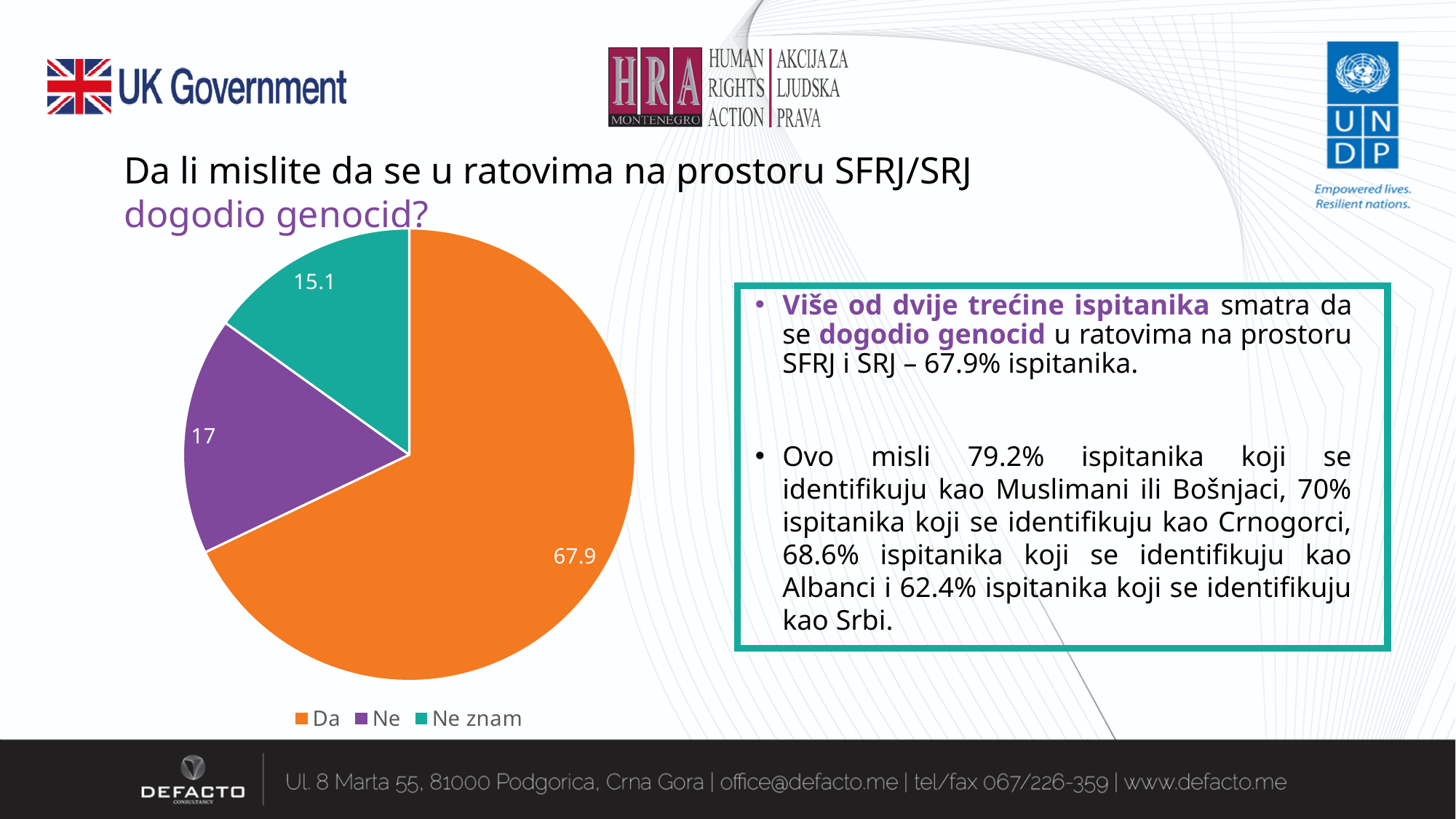
What is the value for the 'Ne znam' slice of the pie chart? 15.1 Which category has the largest slice in the pie chart? Da What is the difference between the 'Ne' and 'Ne znam' values in the pie chart? 1.9 Which colour represents 'Ne' in the pie chart? purple What type of chart is shown on the slide? pie chart What are the legend entries of the pie chart? Da, Ne, Ne znam Which is larger in the pie chart, 'Ne' or 'Ne znam'? Ne How many categories does the pie chart have? 3 What is the value for the 'Ne' slice of the pie chart? 17 What is the difference between the 'Da' and 'Ne' values in the pie chart? 50.9 What is the value for the 'Da' slice of the pie chart? 67.9 Which category has the smallest slice in the pie chart? Ne znam